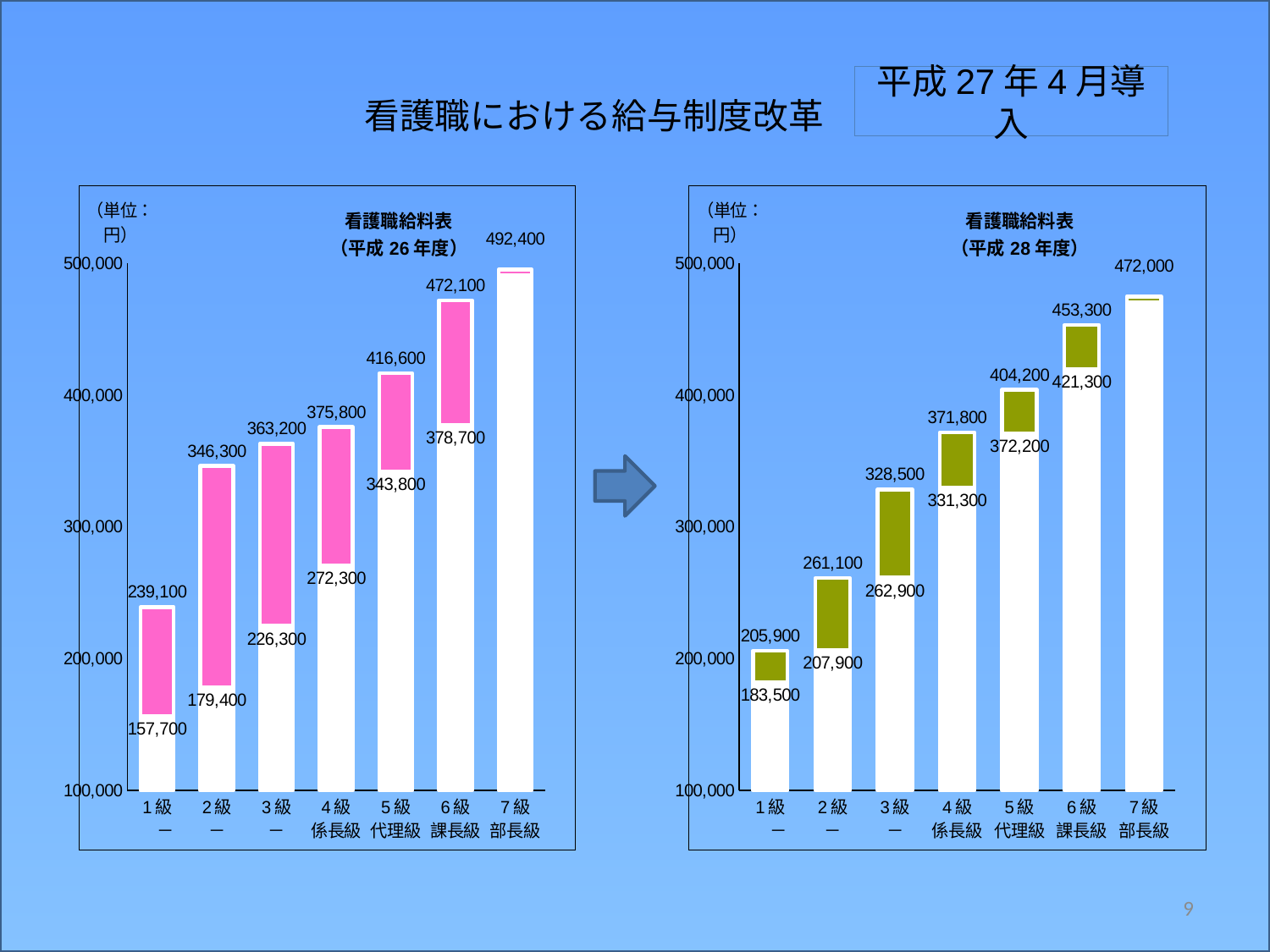
In the 看護職給料表（平成26年度） chart on the left, what is the lower value shown for 6級 課長級? 378,700 In the 看護職給料表（平成26年度） chart on the left, which grade has the highest value? 7級 部長級 What kind of chart is the 看護職給料表（平成26年度） chart on the left? Bar chart In the 看護職給料表（平成26年度） chart on the left, what is the upper value shown for 1級? 239,100 How many grade categories are shown on the x axis of the 看護職給料表（平成28年度） chart on the right? 7 In the 看護職給料表（平成28年度） chart on the right, what is the difference between the upper and lower values for 4級 係長級? 40,500 In the 看護職給料表（平成28年度） chart on the right, do the upper values rise or fall from 1級 to 7級? Rise In the 看護職給料表（平成26年度） chart on the left, what is the difference between the upper and lower values for 2級? 166,900 In the 看護職給料表（平成28年度） chart on the right, what is the lower value shown for 3級? 262,900 Which is larger: the value for 7級 部長級 in the left chart (平成26年度) or in the right chart (平成28年度)? Left chart (平成26年度), 492,400 In the 看護職給料表（平成28年度） chart on the right, what is the upper value shown for 5級 代理級? 404,200 In the 看護職給料表（平成28年度） chart on the right, which grade has the lowest value? 1級